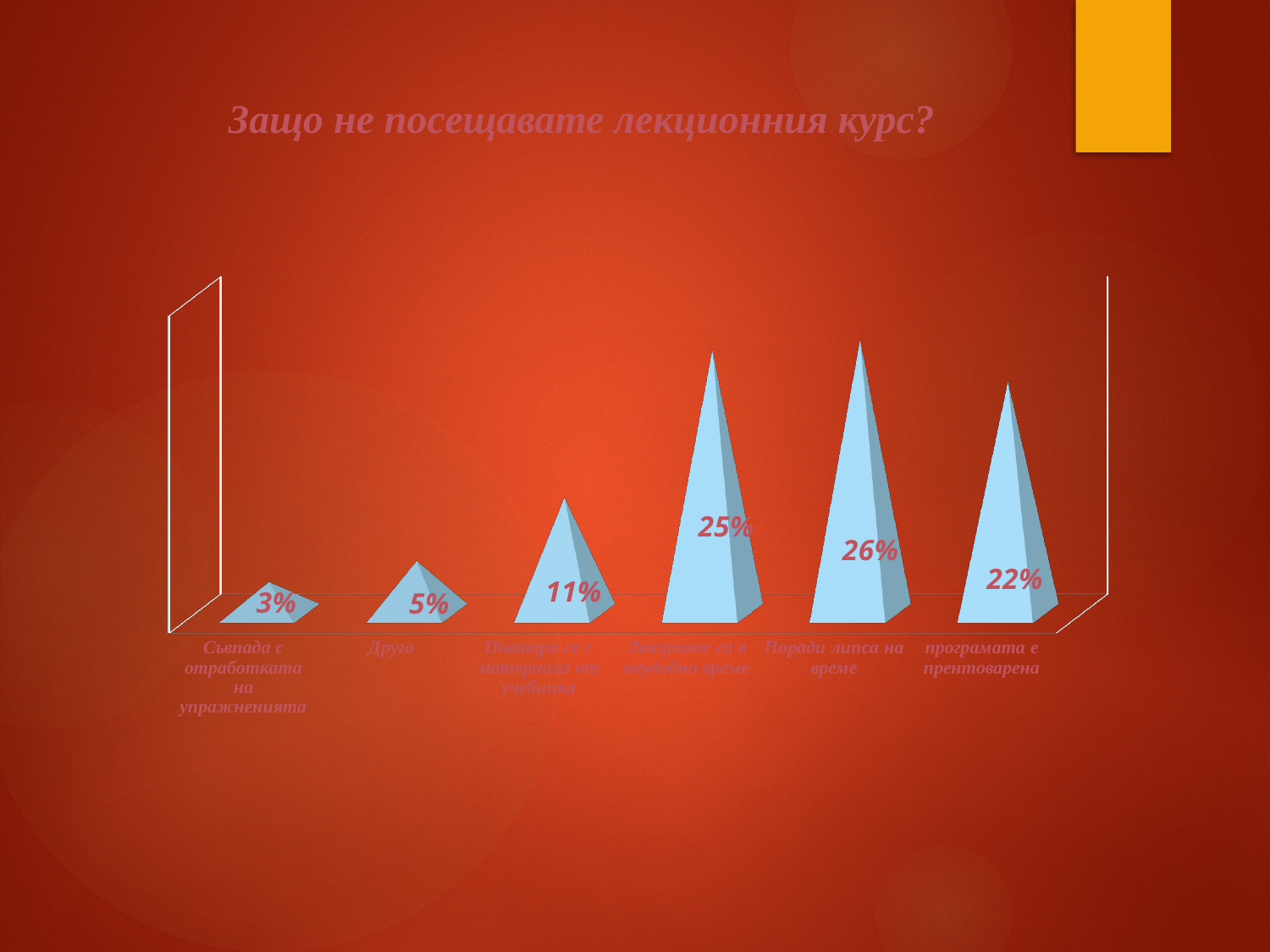
What is the value for "Съвпада с отработката на упражненията"? 3% Which category has the lowest value? Съвпада с отработката на упражненията What is the title of the chart? Защо не посещавате лекционния курс? What is the value for "програмата е прентоварена"? 22% What is the difference between the values for "Поради липса на време" and "програмата е прентоварена"? 4% How many categories are shown in the chart? 6 What kind of chart is shown on the slide? Bar chart What is the difference between the values for "Лекциите са в неудобно време" and "Повтаря се с материала от учебника"? 14% What is the value for "Друго"? 5% Which category has the highest value? Поради липса на време Which is larger, the value for "Друго" or the value for "програмата е прентоварена"? програмата е прентоварена What is the value for "Поради липса на време"? 26%